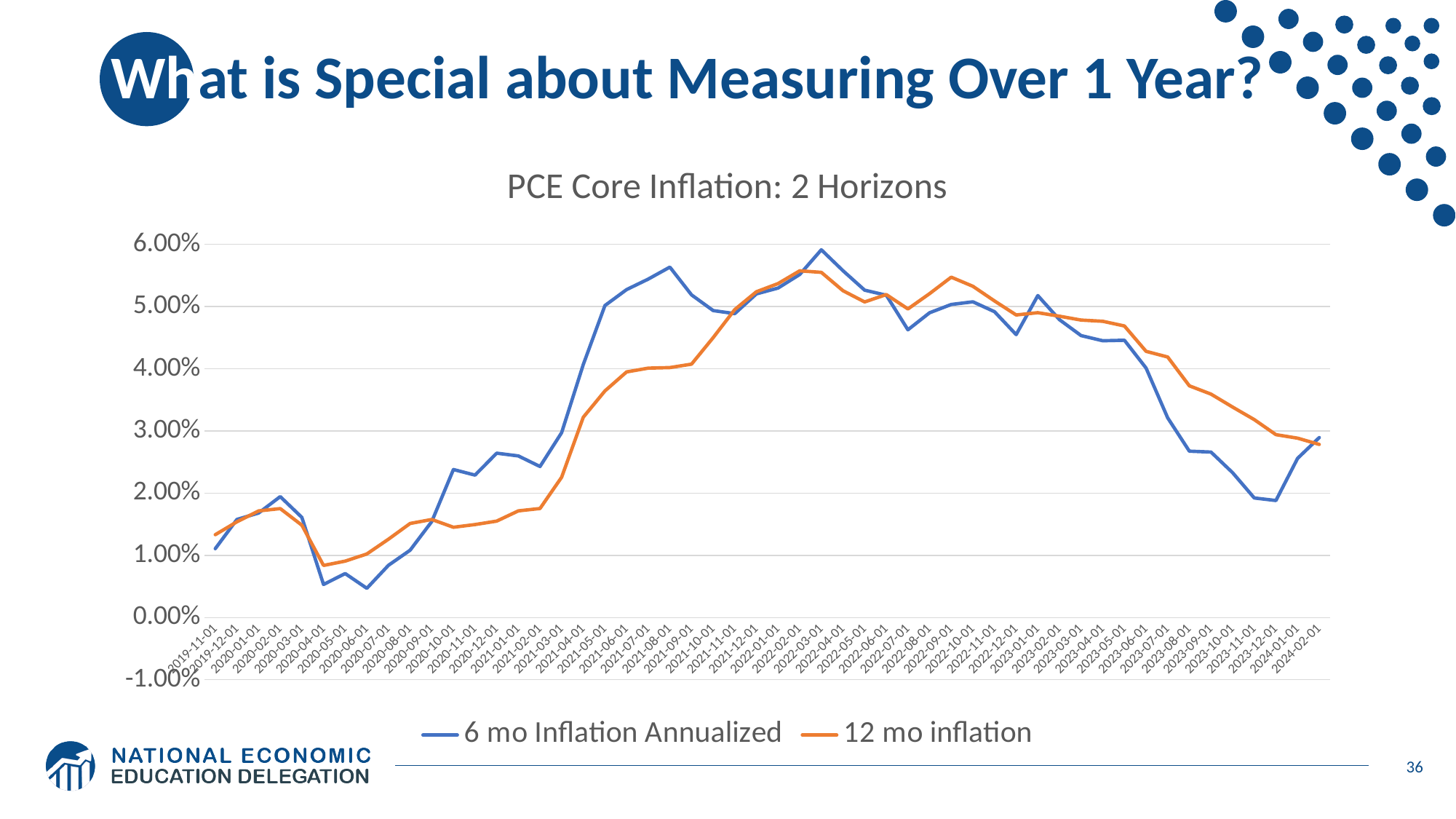
At 2021-08-01, which series has the higher value: 6 mo Inflation Annualized or 12 mo inflation? 6 mo Inflation Annualized What is the title of the chart? PCE Core Inflation: 2 Horizons How many series does the legend list? 2 Which colour is used for the 12 mo inflation series? Orange Is the value of 12 mo inflation at 2021-02-01 greater or less than 2.00%? less At 2023-09-01, which series has the higher value: 6 mo Inflation Annualized or 12 mo inflation? 12 mo inflation Is the value of 6 mo Inflation Annualized at 2020-05-01 greater or less than 1.00%? less At which date does the 6 mo Inflation Annualized series reach its highest value? 2022-03-01 Is the value of 12 mo inflation at 2023-11-01 greater or less than 3.00%? greater Does the 6 mo Inflation Annualized series generally rise or fall between 2022-03-01 and 2024-02-01? Fall What type of chart is shown on the slide? Line chart